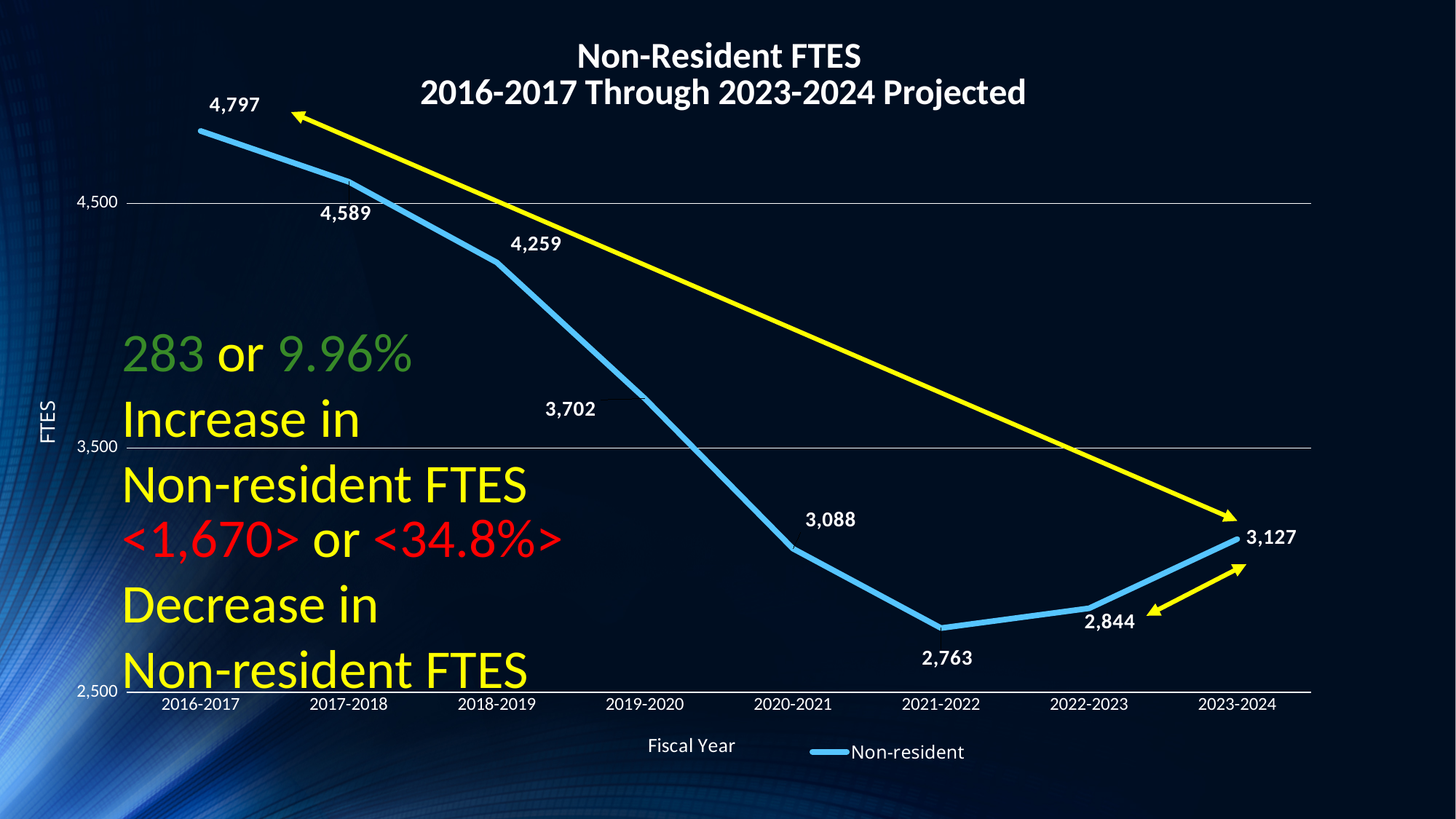
What is the projected Non-Resident FTES value for 2023-2024? 3,127 What is the Non-Resident FTES value for 2019-2020? 3,702 What is the title of the chart? Non-Resident FTES 2016-2017 Through 2023-2024 Projected What is the Non-Resident FTES value for 2021-2022? 2,763 Which fiscal year has the highest Non-Resident FTES? 2016-2017 What type of chart is shown on the slide? Line chart What is the difference in Non-Resident FTES between 2016-2017 and 2017-2018? 208 What is the Non-Resident FTES value for 2016-2017? 4,797 Which fiscal year has a higher Non-Resident FTES, 2020-2021 or 2022-2023? 2020-2021 What is the difference in Non-Resident FTES between 2022-2023 and 2023-2024? 283 How many fiscal years are plotted on the chart? 8 Which fiscal year has the lowest Non-Resident FTES? 2021-2022